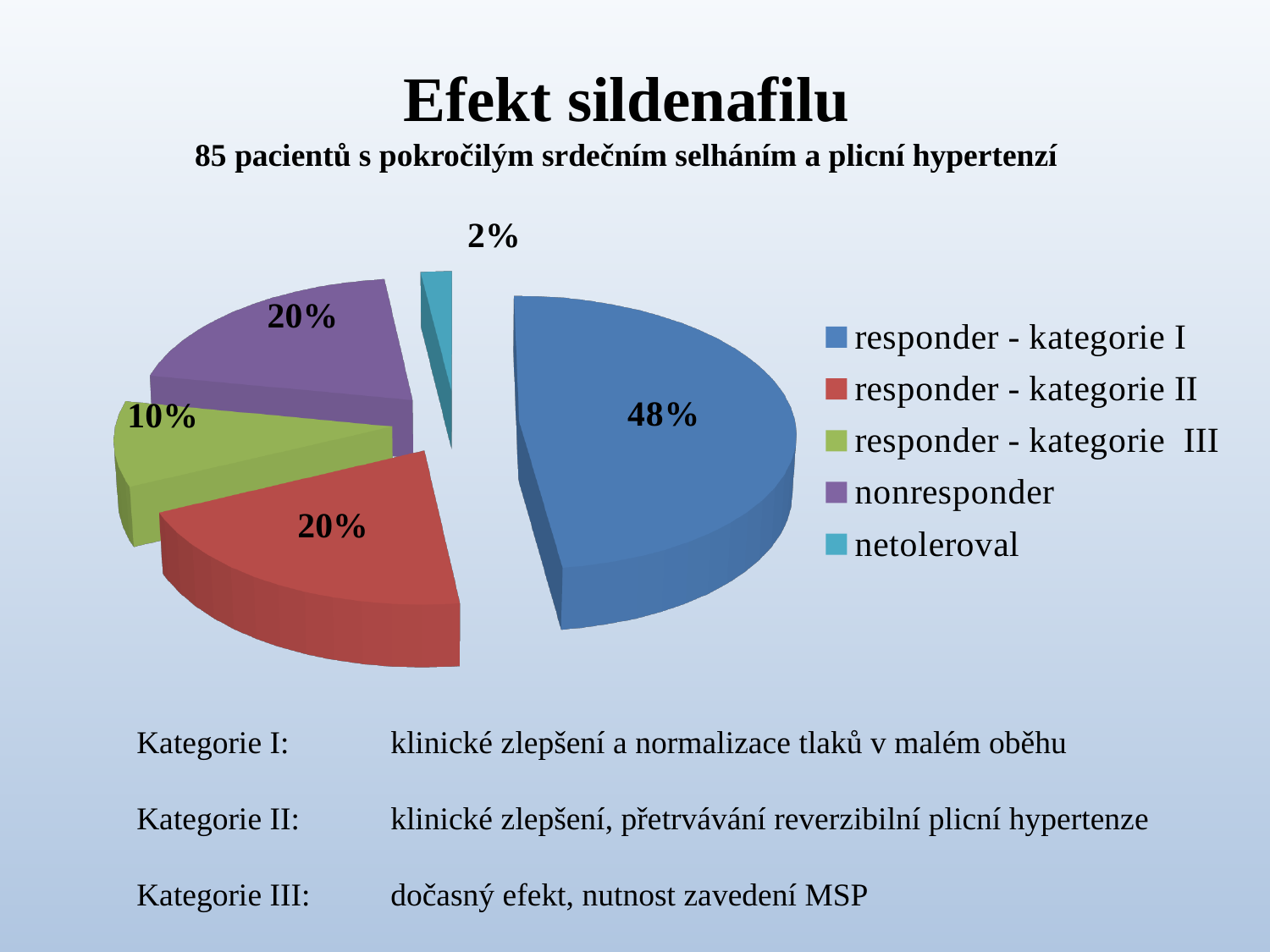
Which category has the largest slice of the pie? responder - kategorie I How many entries does the legend list? 5 Which is larger, the share for "responder - kategorie III" or the share for "netoleroval"? responder - kategorie III What is the value shown for "netoleroval"? 2% What share of the pie does "responder - kategorie I" represent? 48% Which category has the smallest slice of the pie? netoleroval What is the difference between the share for "responder - kategorie I" and the share for "responder - kategorie III"? 38% What is the value shown for "nonresponder"? 20% What is the title of the slide containing the chart? Efekt sildenafilu What kind of chart is shown on the slide? pie chart What is the value shown for "responder - kategorie II"? 20% What is the value shown for "responder - kategorie III"? 10%